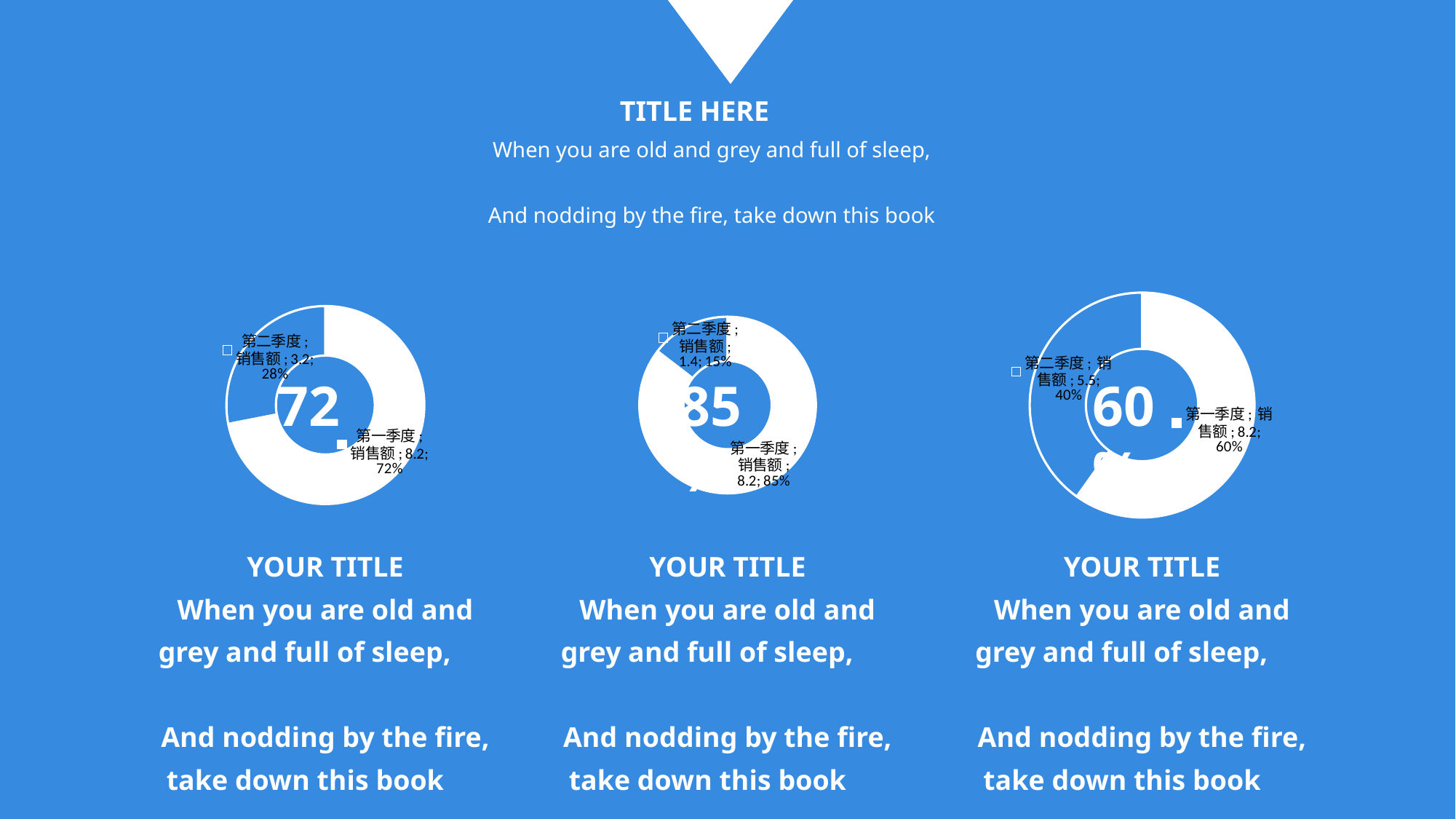
What number is displayed in the centre of the middle chart? 85 In the middle chart, what is the value for 第二季度 销售额? 1.4 In the right chart, what percentage share does 第一季度 销售额 have? 60% In the left chart, what is the value for 第一季度 销售额? 8.2 In the middle chart, what is the difference between the 第一季度 and 第二季度 values? 6.8 In the right chart, which category has the larger value, 第一季度 or 第二季度? 第一季度 In the right chart, what is the value for 第二季度 销售额? 5.5 What kind of chart is the left chart? Doughnut chart How many categories does the right chart show? 2 In the left chart, what is the difference between the 第一季度 and 第二季度 values? 5 In the left chart, what percentage share does 第二季度 销售额 have? 28% In the middle chart, what percentage share does 第一季度 销售额 have? 85%